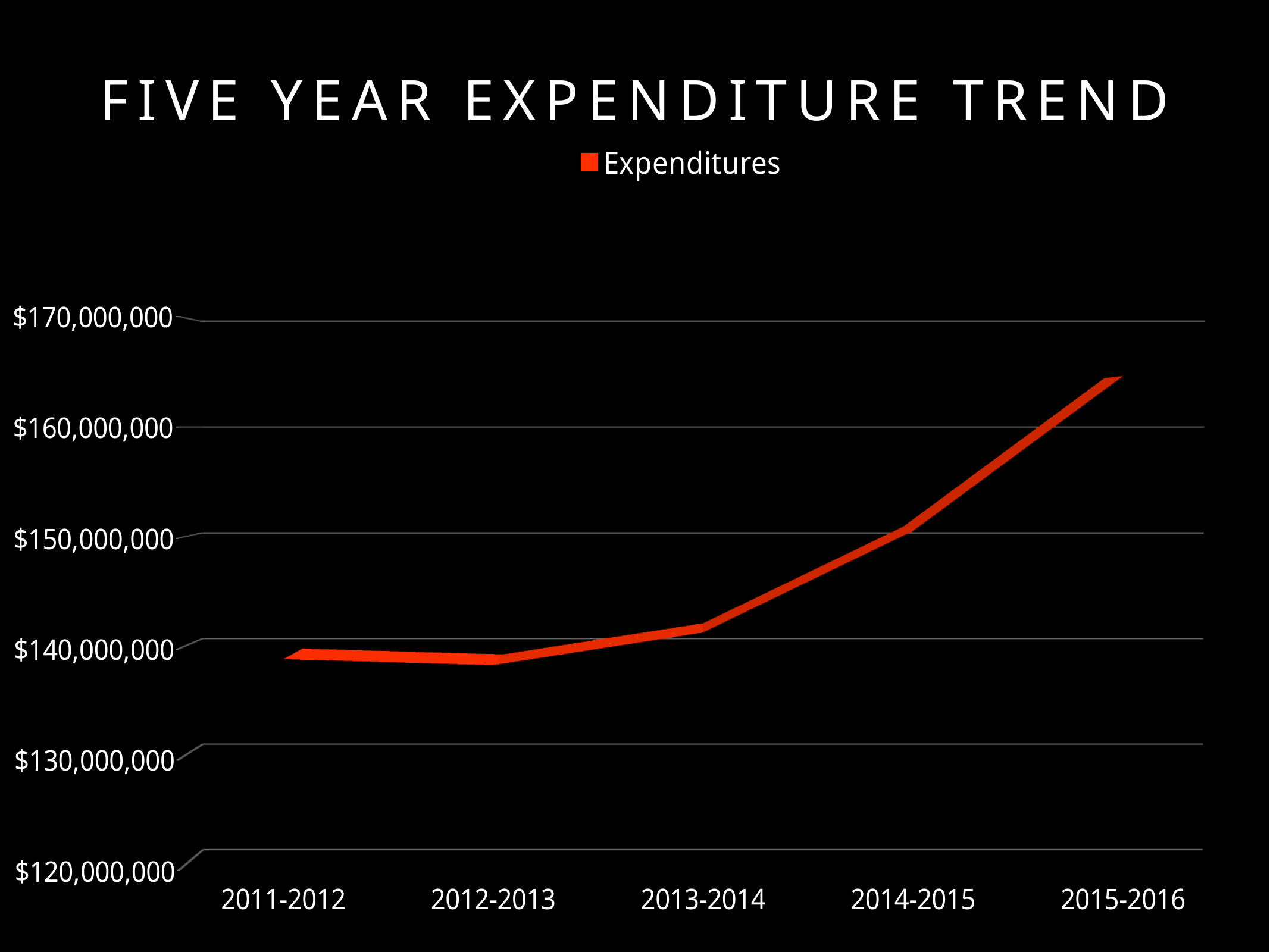
What is the title of the chart? FIVE YEAR EXPENDITURE TREND Is the value for 2015-2016 greater or less than $160,000,000? greater How many fiscal years are plotted on the x axis? 5 What series does the legend list? Expenditures What kind of chart is shown on the slide? line chart Do expenditures generally rise or fall from 2011-2012 to 2015-2016? rise Is the value for 2015-2016 greater or less than $170,000,000? less Which fiscal year has the highest expenditures? 2015-2016 How many series does the legend list? 1 Which is larger, the expenditures for 2015-2016 or for 2011-2012? 2015-2016 Is the value for 2014-2015 greater or less than $140,000,000? greater